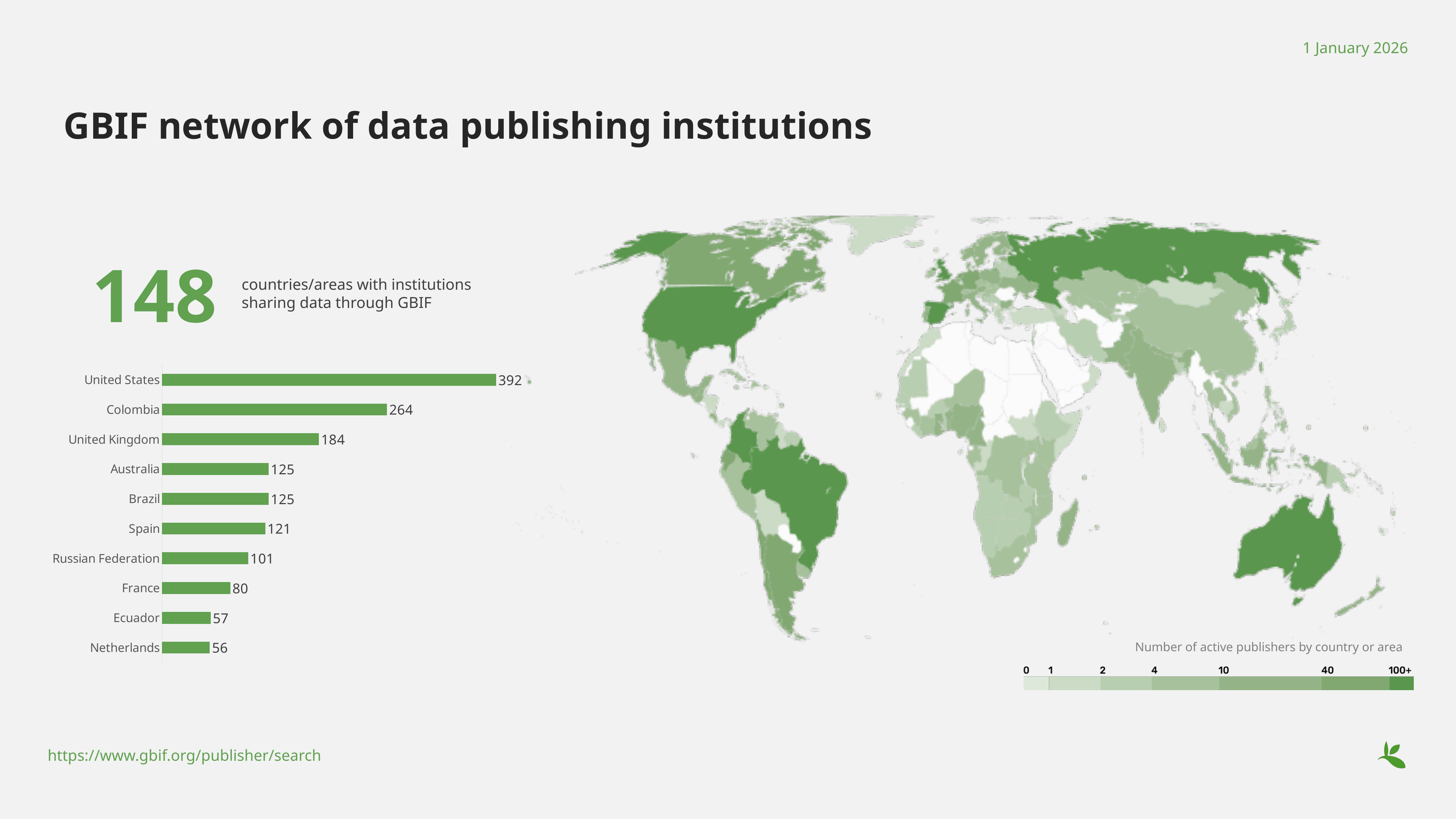
In the bar chart, what is the value for Colombia? 264 In the bar chart, which has a larger value, France or Ecuador? France In the bar chart, what is the difference between the values for Spain and France? 41 How many countries are shown in the bar chart? 10 In the bar chart, which country has the lowest value? Netherlands In the bar chart, which country has the highest value? United States In the bar chart, which has a larger value, Colombia or Australia? Colombia What is the highest value shown on the map's colour legend? 100+ In the bar chart, what is the value for the Russian Federation? 101 In the bar chart, what is the difference between the values for the United States and the United Kingdom? 208 In the bar chart, what is the value for Ecuador? 57 What kind of chart is shown on the left of the slide? Bar chart